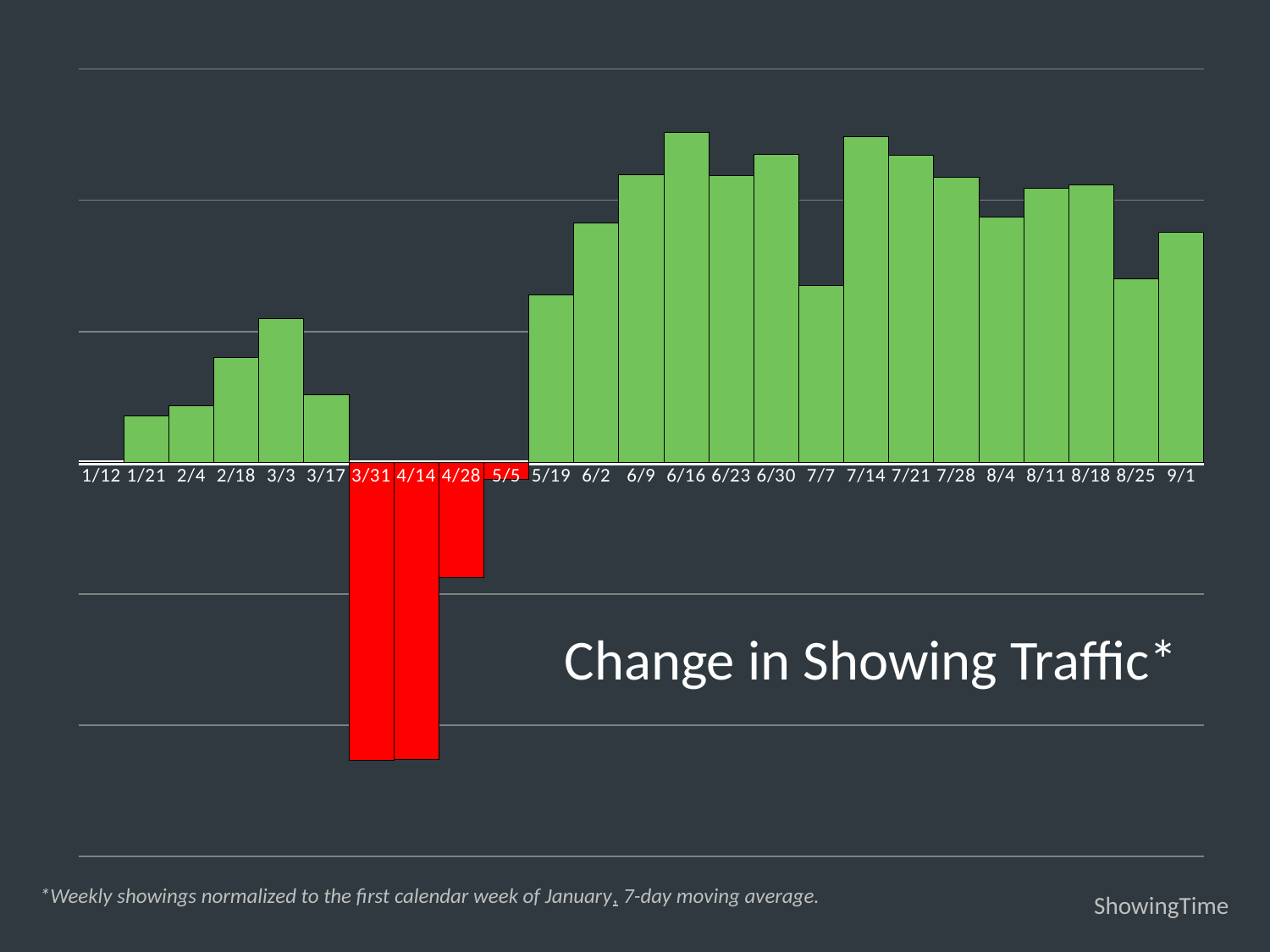
Which two dates have the lowest values in the chart? 3/31 and 4/14 How many bars in the chart show a negative value (extend below the baseline)? 4 How many dates are plotted along the x axis of the chart? 25 Do the values rise or fall from 7/14 to 8/4? fall What is the title of the chart? Change in Showing Traffic* Which is larger, the value for 8/25 or the value for 9/1? 9/1 Which is larger, the value for 6/30 or the value for 7/7? 6/30 What colour are the bars that extend below the baseline? red Do the values rise or fall from 1/12 to 3/3? rise Which is larger, the value for 3/3 or the value for 3/17? 3/3 What kind of chart is shown on the slide? bar chart